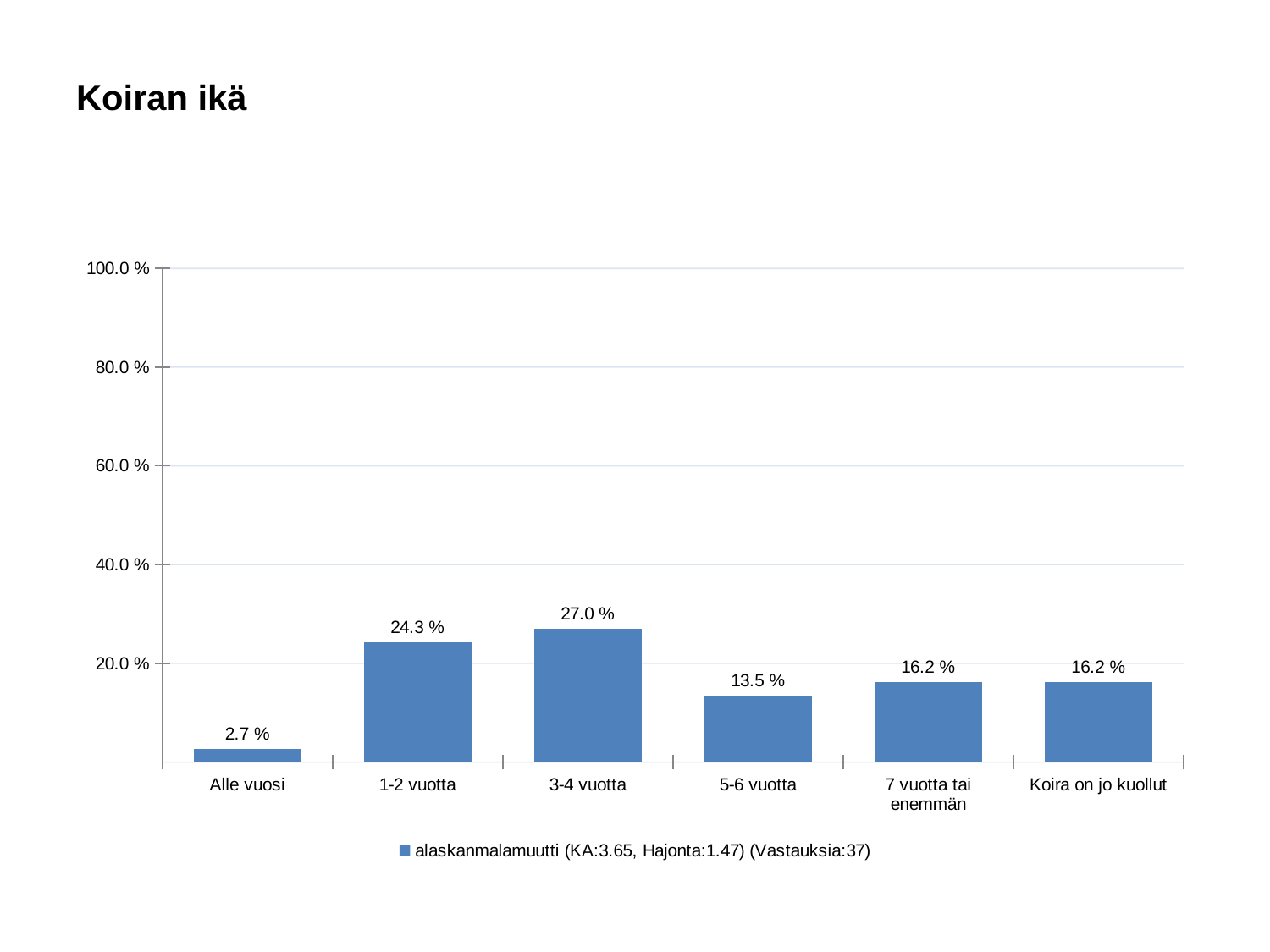
What is the difference between the values for "3-4 vuotta" and "1-2 vuotta"? 2.7 % How many series does the legend list? 1 What kind of chart is shown on the slide? bar chart How many categories are shown on the x axis? 6 Which category has the highest value? 3-4 vuotta What is the value for "3-4 vuotta"? 27.0 % What is the value for "Alle vuosi"? 2.7 % Which is larger, the value for "1-2 vuotta" or the value for "5-6 vuotta"? 1-2 vuotta What is the value for "5-6 vuotta"? 13.5 % Is the value for "1-2 vuotta" greater or less than 20.0 %? greater What is the title of the slide? Koiran ikä Which category has the lowest value? Alle vuosi